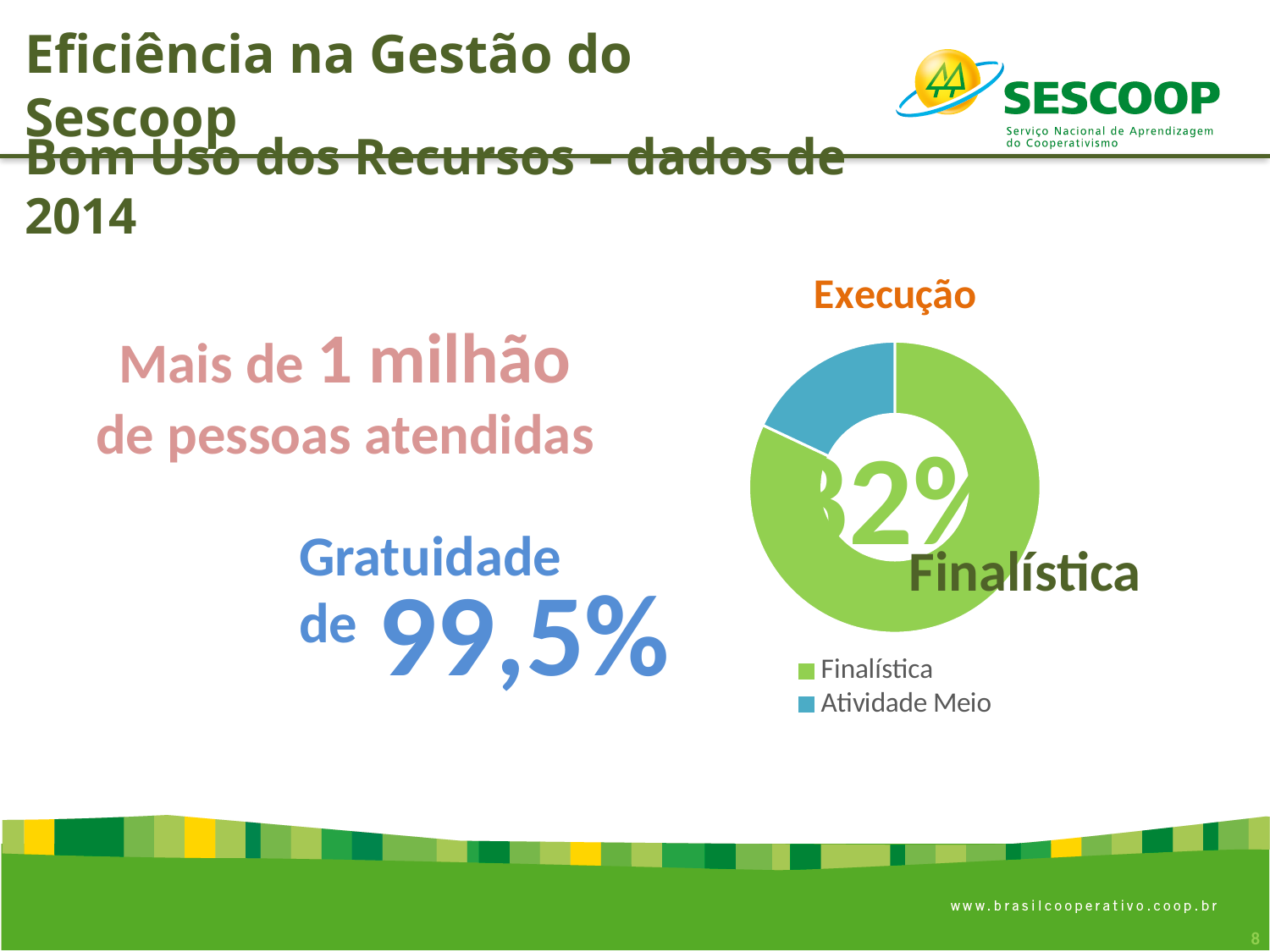
Which slice is larger, Finalística or Atividade Meio? Finalística How many slices does the chart have? 2 What colour is the Atividade Meio slice in the chart? Blue What kind of chart is shown on the slide? Doughnut chart How many entries does the chart's legend list? 2 Which category has the smallest slice in the chart? Atividade Meio Which category has the largest slice in the chart? Finalística What is the title of the chart on the slide? Execução